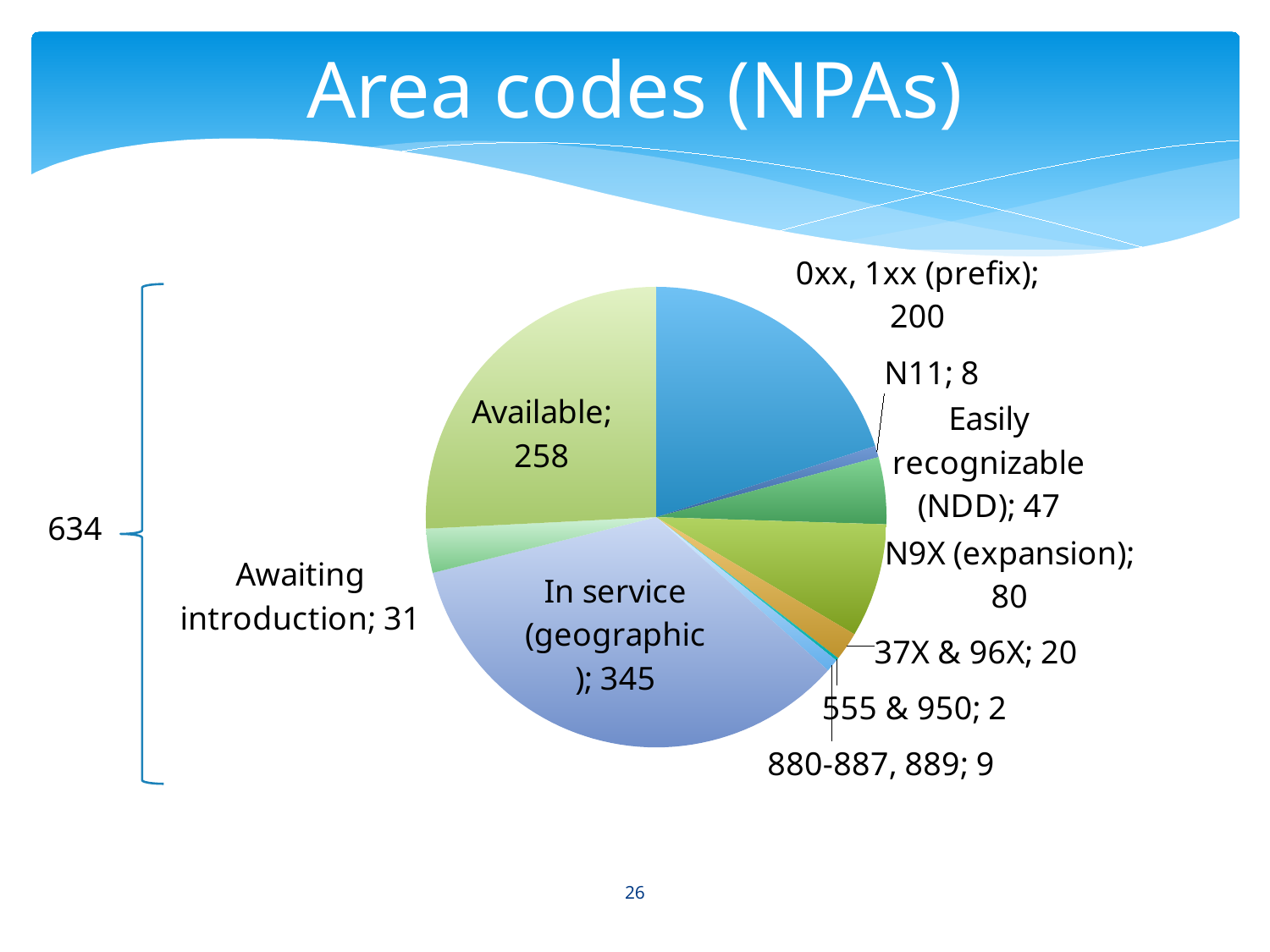
Which category has the smallest slice of the pie? 555 & 950 What is the value for the 'Available' slice? 258 What is the value for the 'In service (geographic)' slice? 345 How many slices does the pie chart have? 10 What is the value for the 'N9X (expansion)' slice? 80 Which category has the largest slice of the pie? In service (geographic) What is the title of the slide containing the pie chart? Area codes (NPAs) What is the value for the 'Easily recognizable (NDD)' slice? 47 What kind of chart is shown on the slide? pie chart Which is larger, the value for '0xx, 1xx (prefix)' or the value for 'N9X (expansion)'? 0xx, 1xx (prefix) What is the difference between the 'In service (geographic)' value and the 'Available' value? 87 What share of the pie does the '0xx, 1xx (prefix)' slice represent? 20%